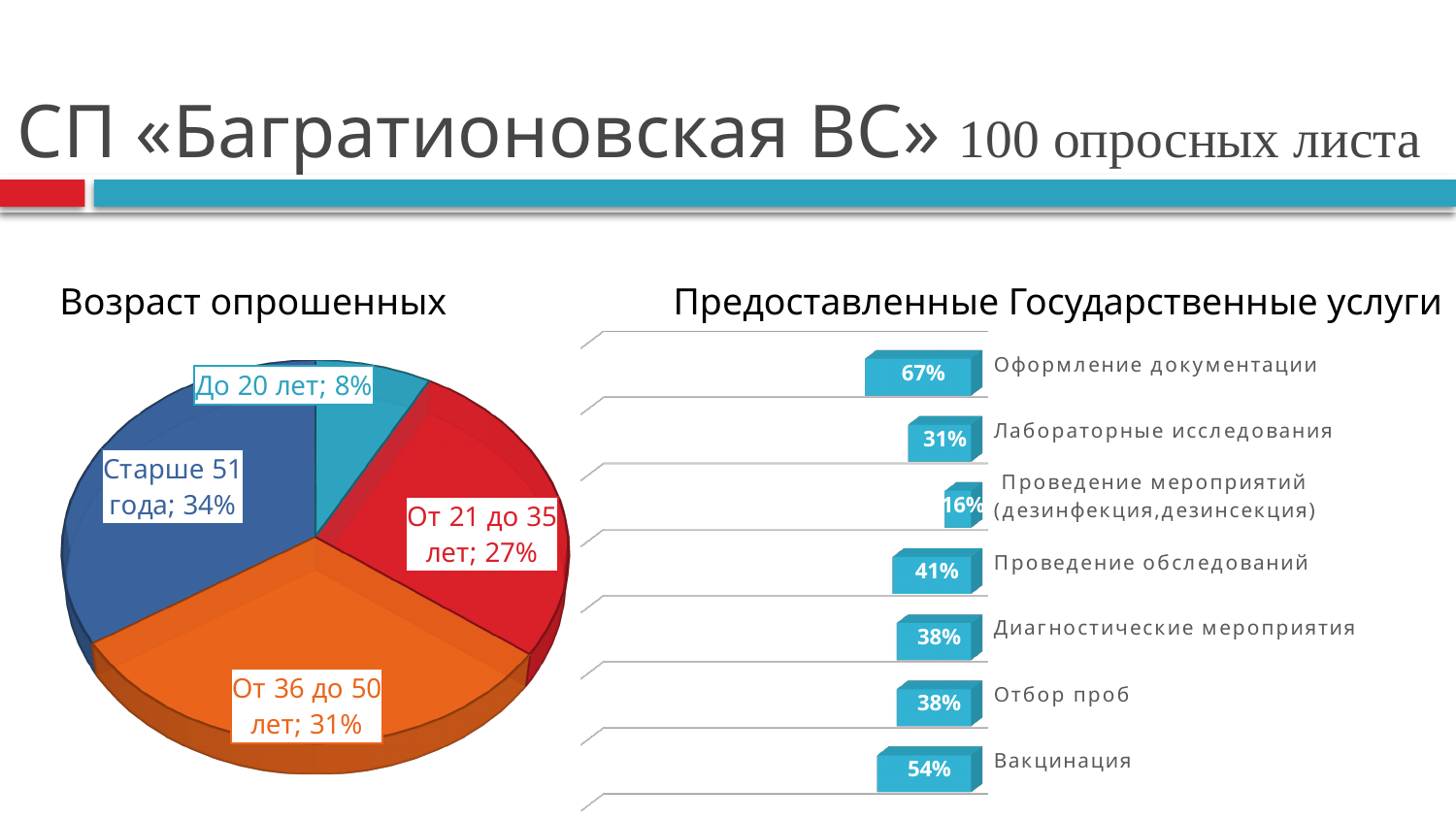
In the chart 'Предоставленные Государственные услуги', which service has the lowest value? Проведение мероприятий (дезинфекция,дезинсекция) What kind of chart is 'Предоставленные Государственные услуги'? Bar chart In the chart 'Предоставленные Государственные услуги', what is the value for 'Вакцинация'? 54% In the chart 'Возраст опрошенных', what is the difference between the shares for 'От 36 до 50 лет' and 'От 21 до 35 лет'? 4% In the chart 'Возраст опрошенных', what share of respondents are 'Старше 51 года'? 34% In the chart 'Возраст опрошенных', which age group has the smallest share? До 20 лет In the chart 'Предоставленные Государственные услуги', which is larger: 'Проведение обследований' or 'Лабораторные исследования'? Проведение обследований In the chart 'Предоставленные Государственные услуги', which service has the highest value? Оформление документации In the chart 'Возраст опрошенных', which age group has the largest share? Старше 51 года In the chart 'Предоставленные Государственные услуги', how many services are listed? 7 In the chart 'Возраст опрошенных', how many slices does the pie have? 4 What kind of chart is 'Возраст опрошенных'? Pie chart